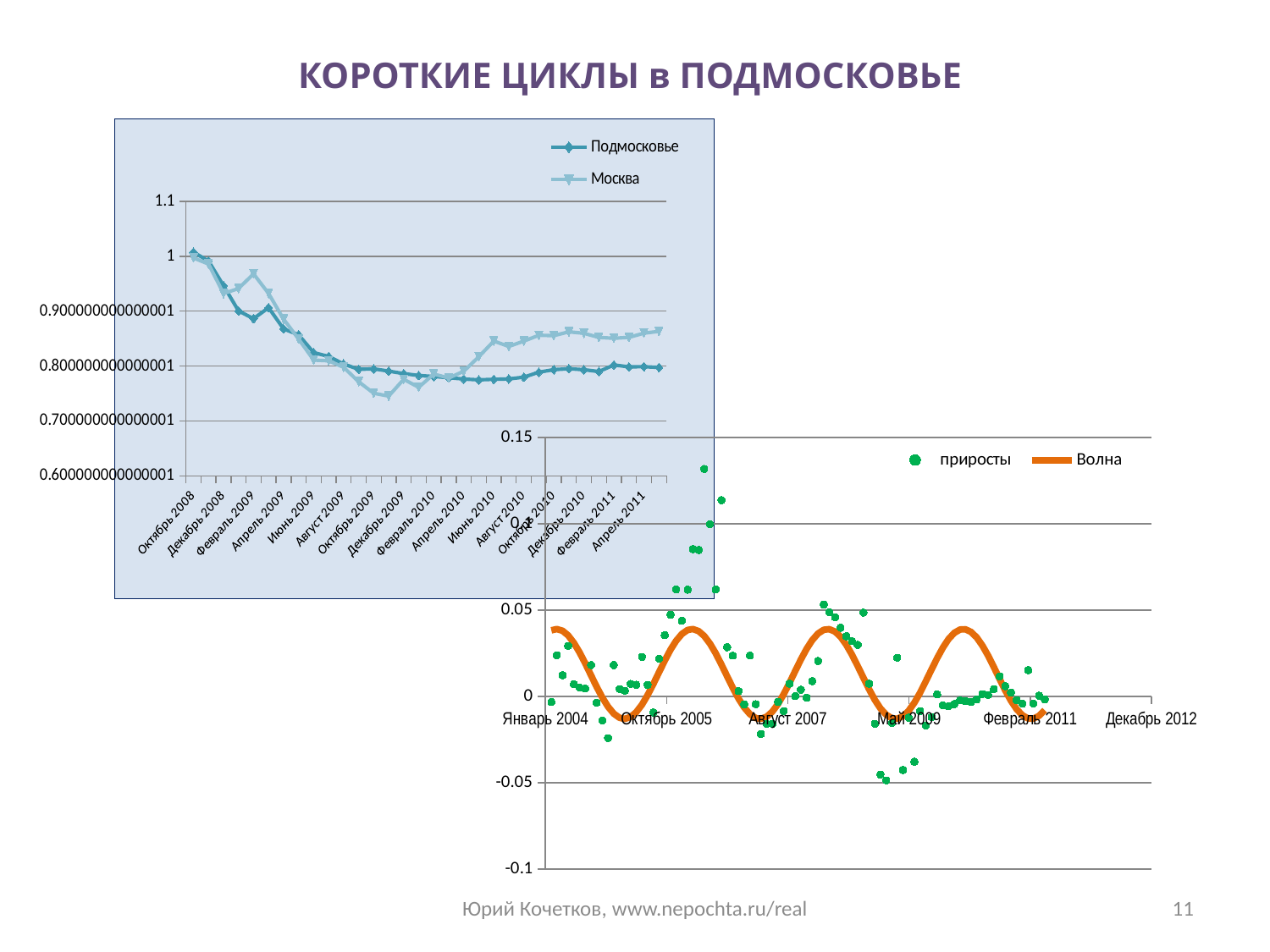
In the bottom-right chart, is the peak value of the Волна line greater or less than 0.05? less What are the two legend entries of the bottom-right chart? приросты and Волна In the top-left chart, does the Подмосковье series rise or fall from Октябрь 2008 to Июнь 2010? fall In the top-left chart, which series has the higher value at Апрель 2011, Подмосковье or Москва? Москва In the top-left chart, is the value for Москва at Апрель 2011 greater or less than 0.8? greater How many series does the legend of the top-left chart list? 2 In the top-left chart, is the value for Подмосковье at Октябрь 2008 greater or less than 0.9? greater How many series does the legend of the bottom-right chart list? 2 What kind of chart is the top-left chart with the Подмосковье and Москва series? line chart In the top-left chart, which series has the higher value at Декабрь 2009, Подмосковье or Москва? Подмосковье What is the title of the slide? КОРОТКИЕ ЦИКЛЫ в ПОДМОСКОВЬЕ